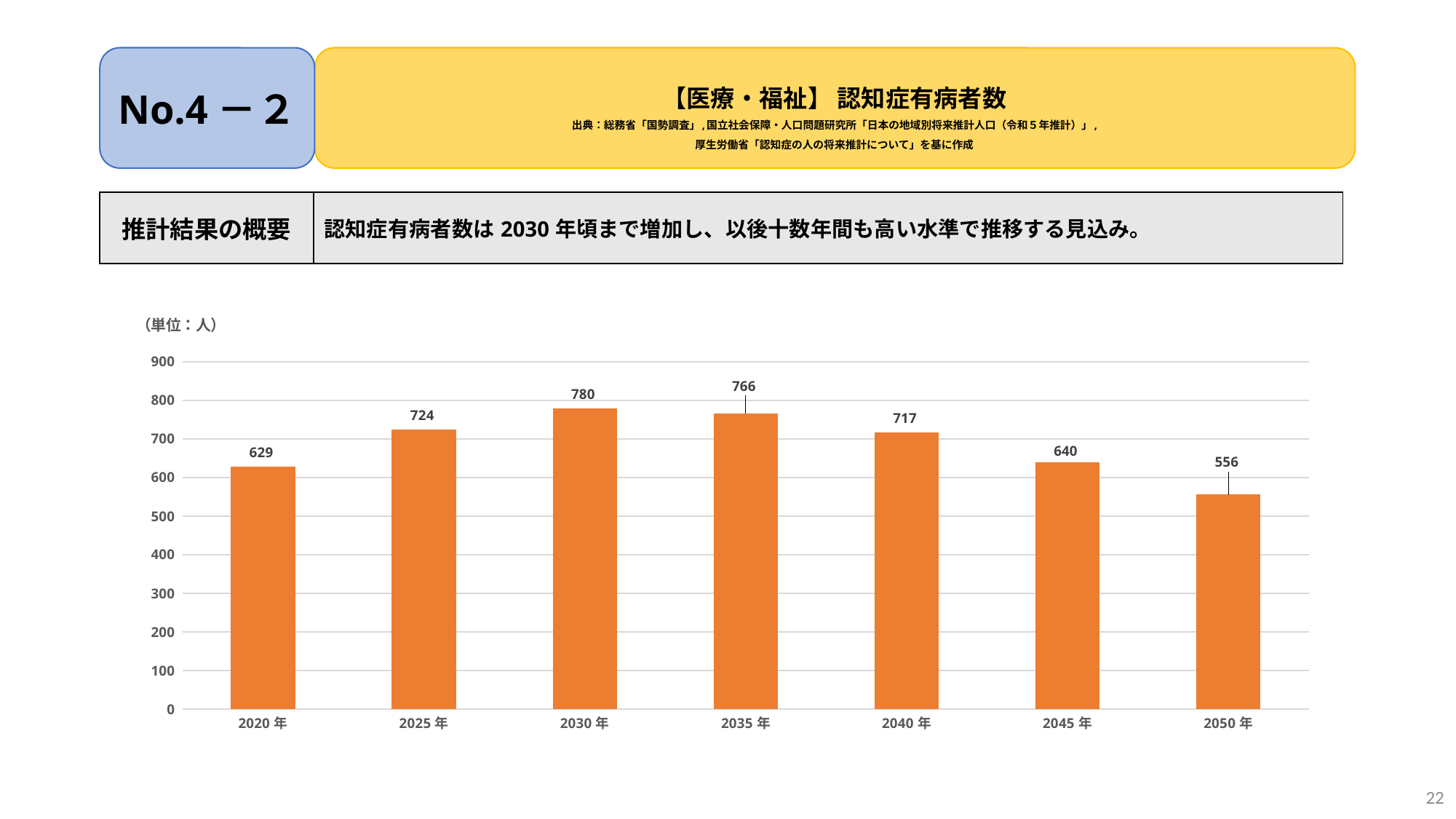
What is the difference between the values for 2030年 and 2020年? 151 How many years are shown on the x axis? 7 What is the value for 2020年? 629 Is the value for 2045年 greater or less than 700? less Which is larger, the value for 2025年 or the value for 2040年? 2025年 What kind of chart is shown on the slide? bar chart What is the difference between the values for 2040年 and 2045年? 77 What is the value for 2035年? 766 Which year has the highest value? 2030年 What unit is indicated above the chart? 人 What is the value for 2050年? 556 Which year has the lowest value? 2050年